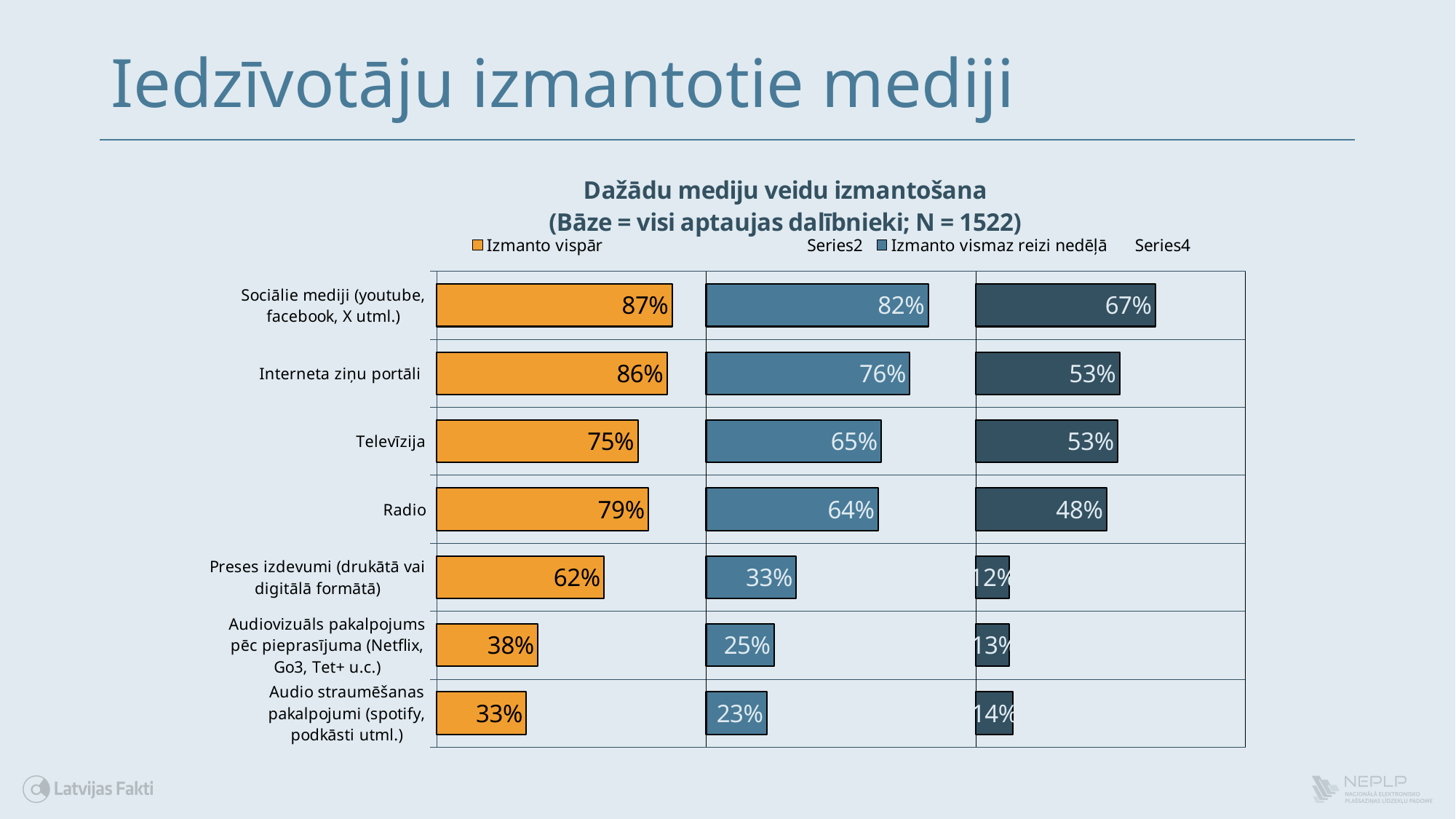
What kind of chart is shown on the slide? bar chart What is the difference between the 'Izmanto vismaz reizi nedēļā' values for Sociālie mediji (youtube, facebook, X utml.) and Interneta ziņu portāli? 6% What is the 'Izmanto vismaz reizi nedēļā' value for Radio? 64% What is the difference between the 'Izmanto vispār' and 'Izmanto vismaz reizi nedēļā' values for Preses izdevumi (drukātā vai digitālā formātā)? 29% Which is larger for 'Izmanto vispār': Radio or Televīzija? Radio What is the title of the chart? Dažādu mediju veidu izmantošana (Bāze = visi aptaujas dalībnieki; N = 1522) What colour are the 'Izmanto vispār' bars? orange Which category has the lowest 'Izmanto vismaz reizi nedēļā' value? Audio straumēšanas pakalpojumi (spotify, podkāsti utml.) How many media categories are listed on the chart? 7 What is the 'Izmanto vispār' value for Audiovizuāls pakalpojums pēc pieprasījuma (Netflix, Go3, Tet+ u.c.)? 38% What is the 'Izmanto vispār' value for Televīzija? 75% Which category has the highest 'Izmanto vispār' value? Sociālie mediji (youtube, facebook, X utml.)